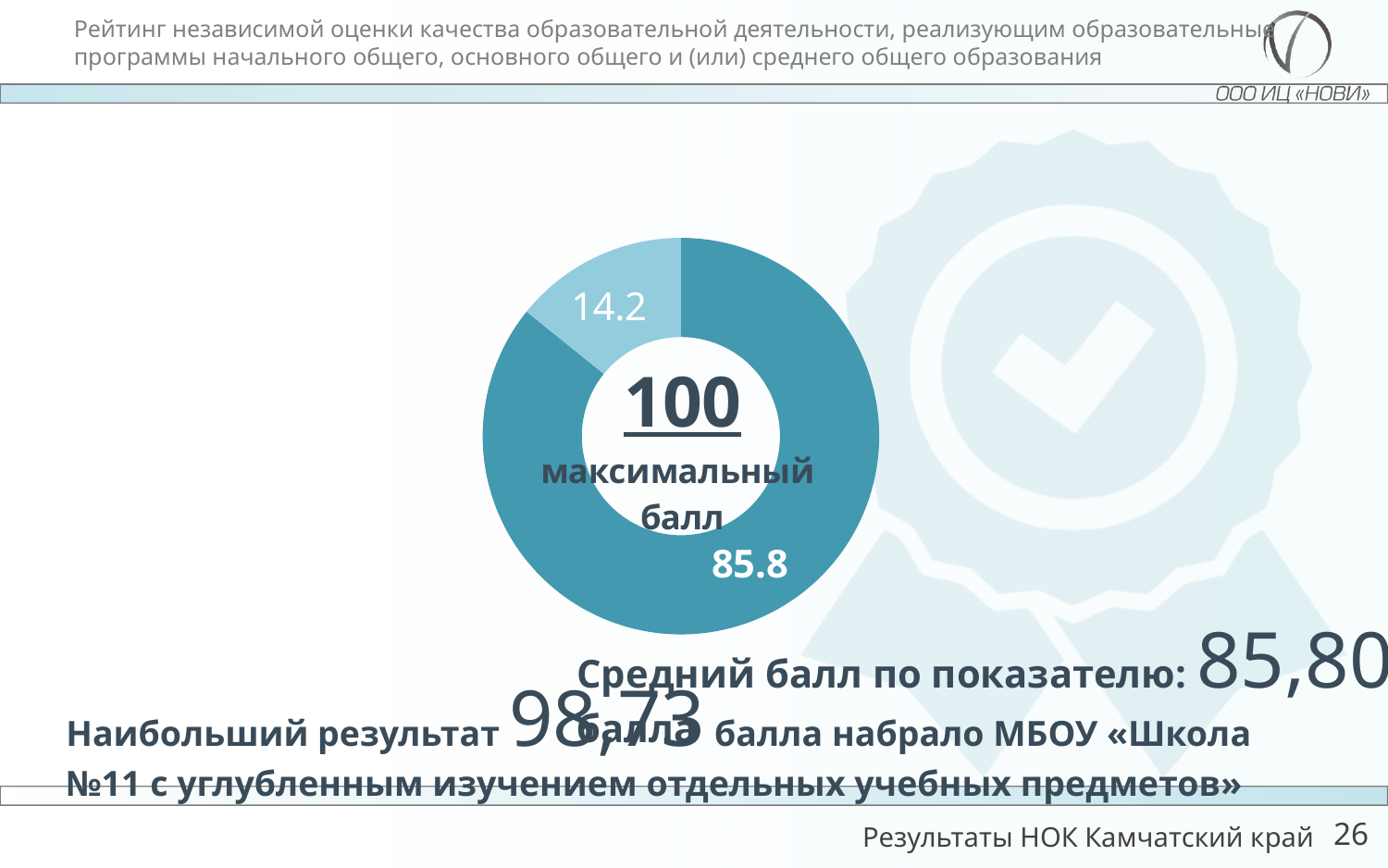
Which slice is larger on the doughnut chart, the dark teal one or the light teal one? the dark teal one How many slices does the doughnut chart have? 2 What number is printed in the centre of the doughnut chart? 100 What is the highest value shown on the doughnut chart? 85.8 What text accompanies the number in the centre of the doughnut chart? максимальный балл What share of the doughnut chart does the slice labelled 85.8 represent? 85.8% What is the lowest value shown on the doughnut chart? 14.2 What is the total of the two slice values on the doughnut chart? 100 What value is printed on the larger, dark teal slice of the doughnut chart? 85.8 What kind of chart is shown on the slide? doughnut chart What value is printed on the smaller, light teal slice of the doughnut chart? 14.2 What is the difference between the two slice values on the doughnut chart? 71.6